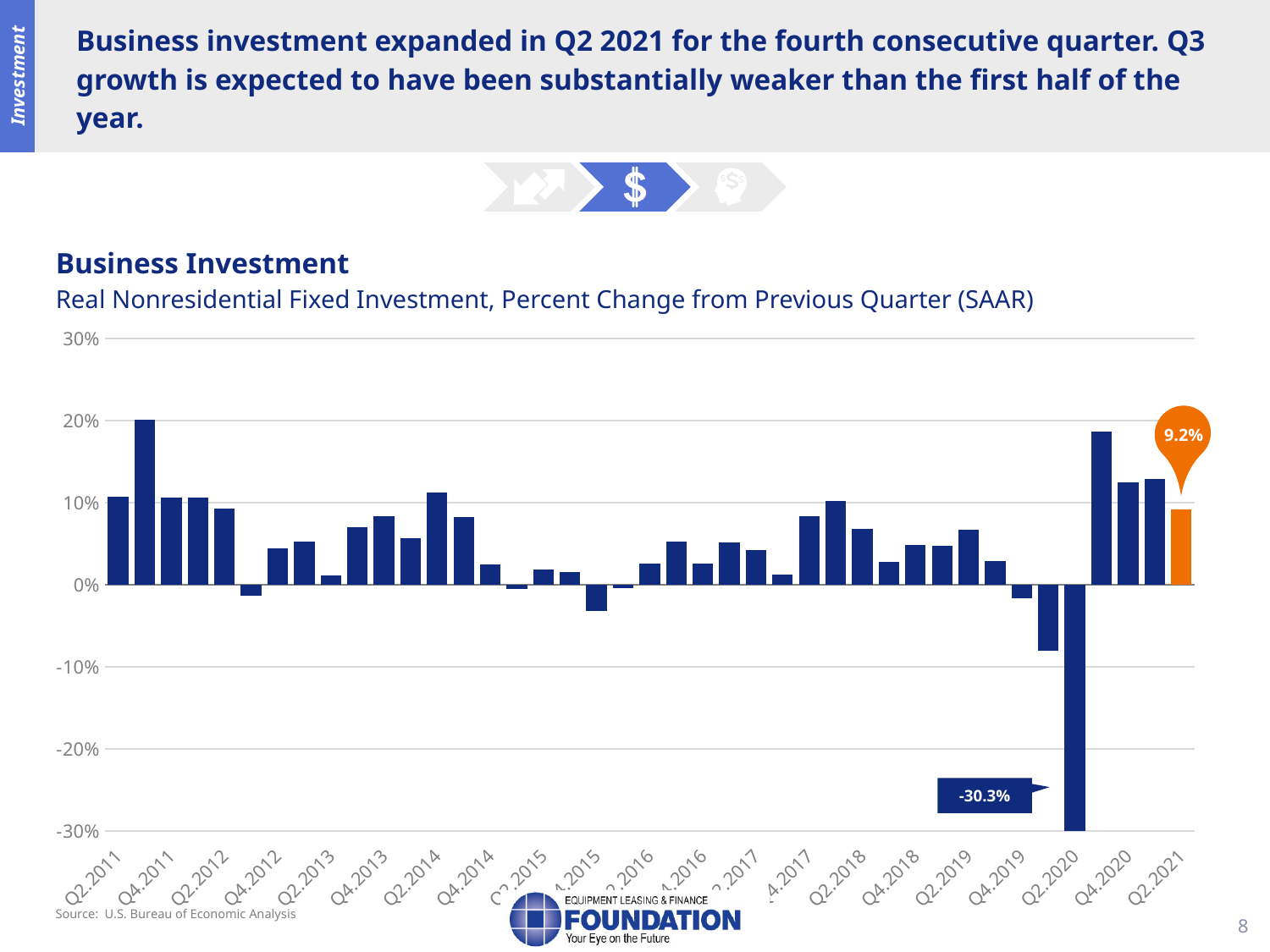
What is the value for Q2 2021? 9.2% Is the value for Q4 2020 greater or less than 10%? greater Is the value for Q2 2020 greater or less than -20%? less What is the title of the chart? Business Investment What is the value for Q2 2020? -30.3% Which quarter has the lowest value? Q2 2020 Which is larger, the value for Q2 2021 or the value for Q2 2020? Q2 2021 Did the value rise or fall from Q2 2020 to Q4 2020? Rise Is the value for Q2 2019 greater or less than 10%? less What is the difference between the Q2 2021 value and the Q2 2020 value? 39.5 percentage points What is the source cited for the chart? U.S. Bureau of Economic Analysis What kind of chart is shown on the slide? Bar chart